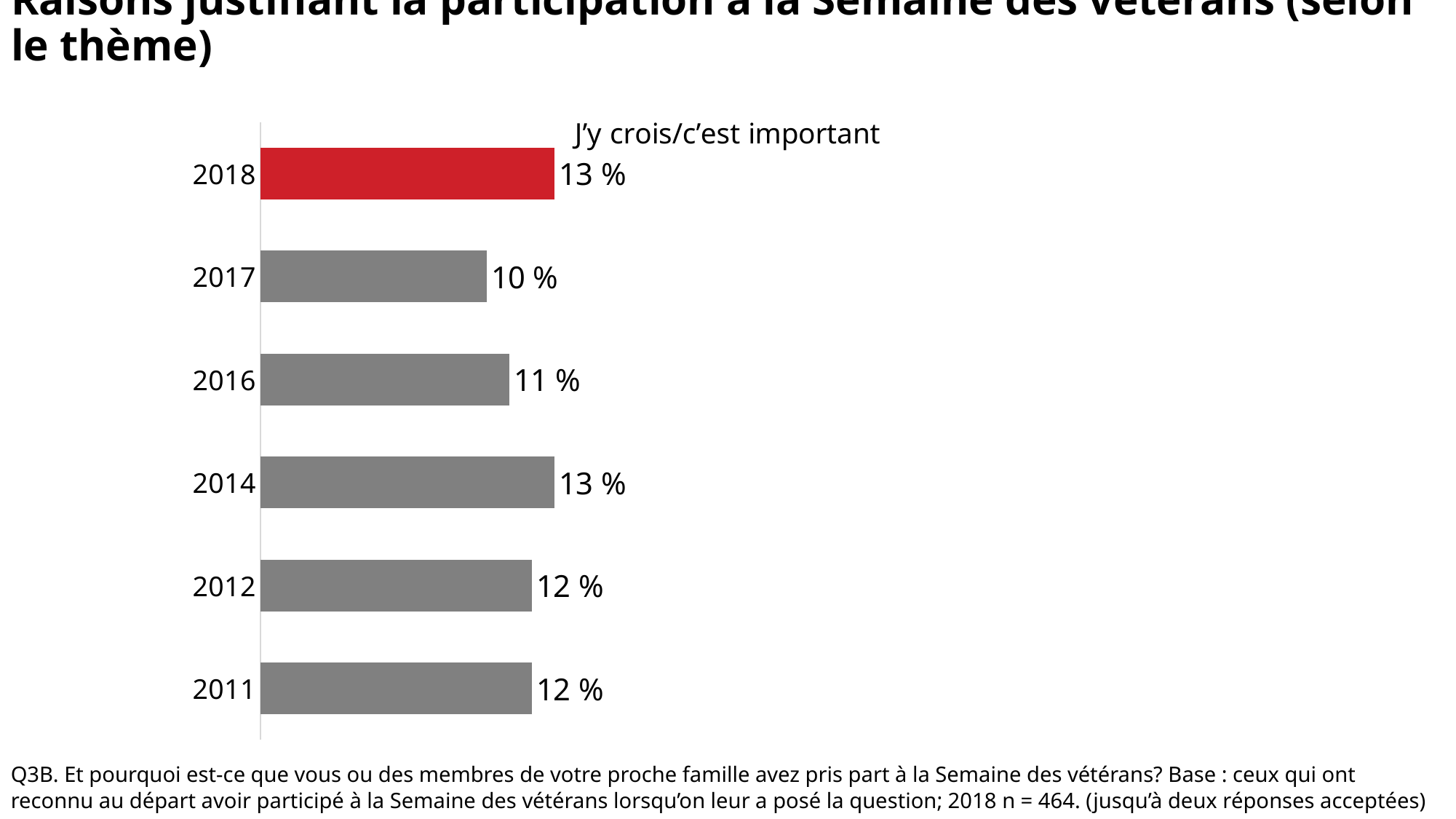
What kind of chart is shown on the slide? Bar chart What is the difference between the values for 2012 and 2016? 1 % What is the label shown above the bars in the chart? J’y crois/c’est important How many years are shown in the chart? 6 What is the value for 2017? 10 % Which year has the lowest value? 2017 What is the value for 2018? 13 % What is the value for 2014? 13 % What is the value for 2016? 11 % What is the value for 2011? 12 % What is the difference between the values for 2018 and 2017? 3 % Which is larger, the value for 2018 or the value for 2016? 2018